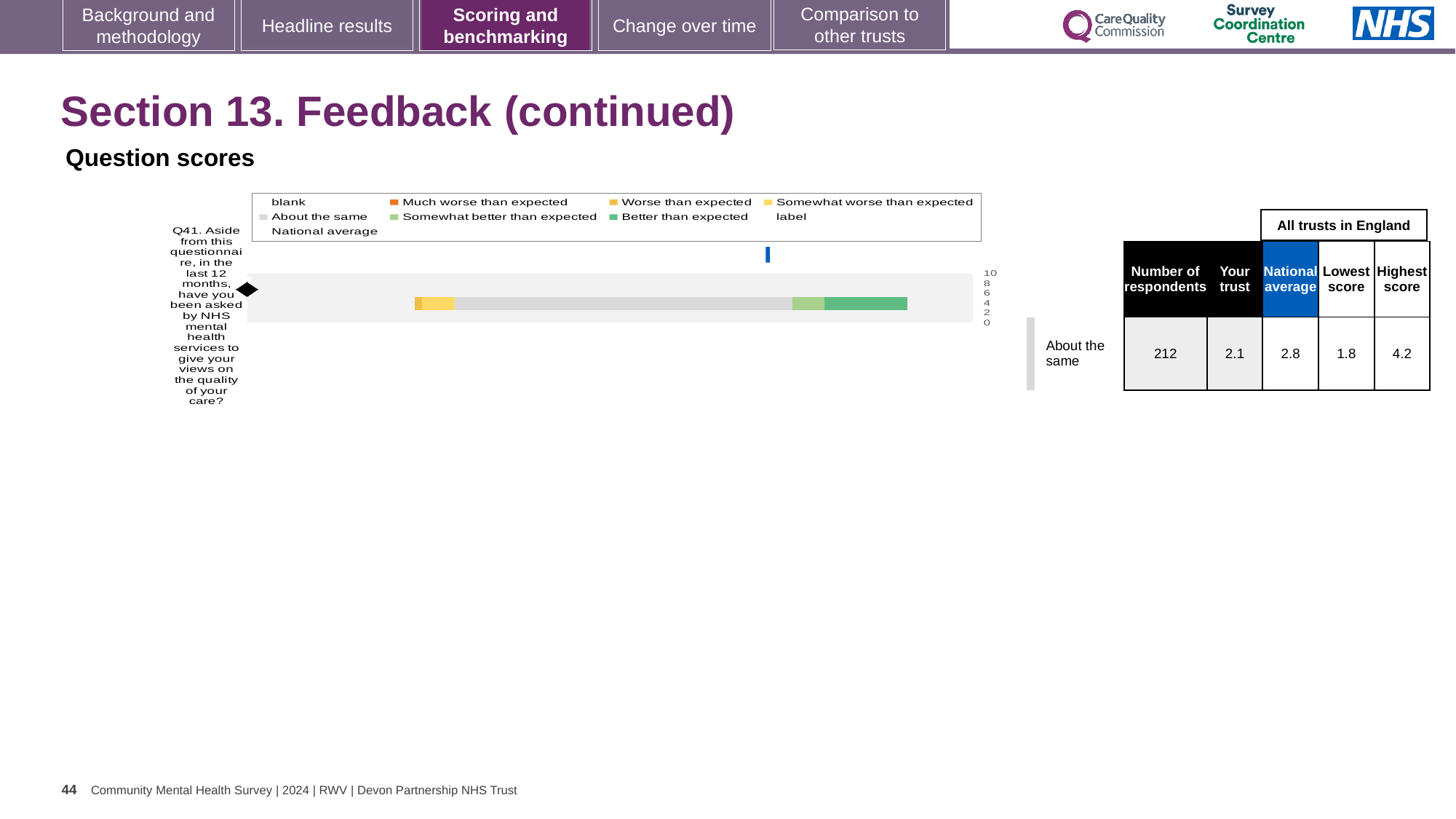
Which is larger for Q41, the trust's score or the national average? national average How many questions (categories) are plotted in the chart? 1 Which expected-range band does the trust's score for Q41 fall into? About the same What is the trust's score for Q41? 2.1 What is the difference between the national average and the trust's score for Q41? 0.7 How many respondents answered Q41? 212 Which question is plotted in the chart? Q41. Aside from this questionnaire, in the last 12 months, have you been asked by NHS mental health services to give your views on the quality of your care? What kind of chart is shown on the slide? bar chart Which legend entry is shown in dark green? Better than expected What is the national average score for Q41? 2.8 How many entries does the chart legend list? 9 What is the difference between the highest and lowest trust scores for Q41? 2.4